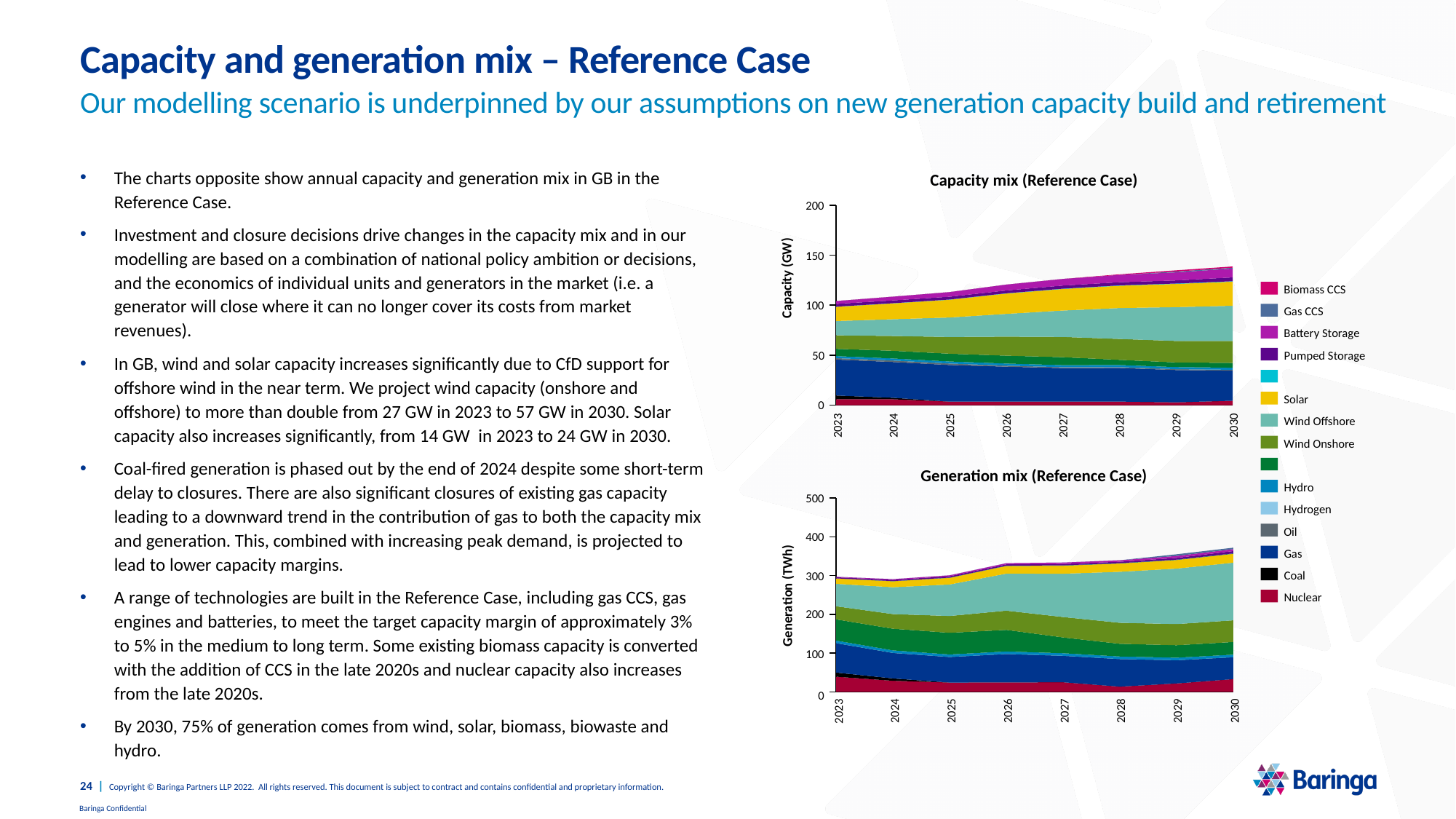
In the 'Generation mix (Reference Case)' chart, is total generation larger in 2023 or in 2030? 2030 In the 'Capacity mix (Reference Case)' chart, is the total capacity in 2030 greater or less than 100? greater In the 'Generation mix (Reference Case)' chart, does total generation rise or fall between 2025 and 2030? Rise In the 'Capacity mix (Reference Case)' chart, does total capacity rise or fall from 2023 to 2030? Rise In the 'Capacity mix (Reference Case)' chart, is the total capacity in 2023 greater or less than 150? less In the 'Capacity mix (Reference Case)' chart, which year has the highest total capacity? 2030 What kind of chart is the 'Capacity mix (Reference Case)' chart? Stacked area chart In the 'Generation mix (Reference Case)' chart, is the total generation in 2030 greater or less than 300? greater What is the y-axis label of the 'Generation mix (Reference Case)' chart? Generation (TWh) How many years are shown on the x axis of the 'Generation mix (Reference Case)' chart? 8 In the 'Capacity mix (Reference Case)' chart, which year has the lowest total capacity? 2023